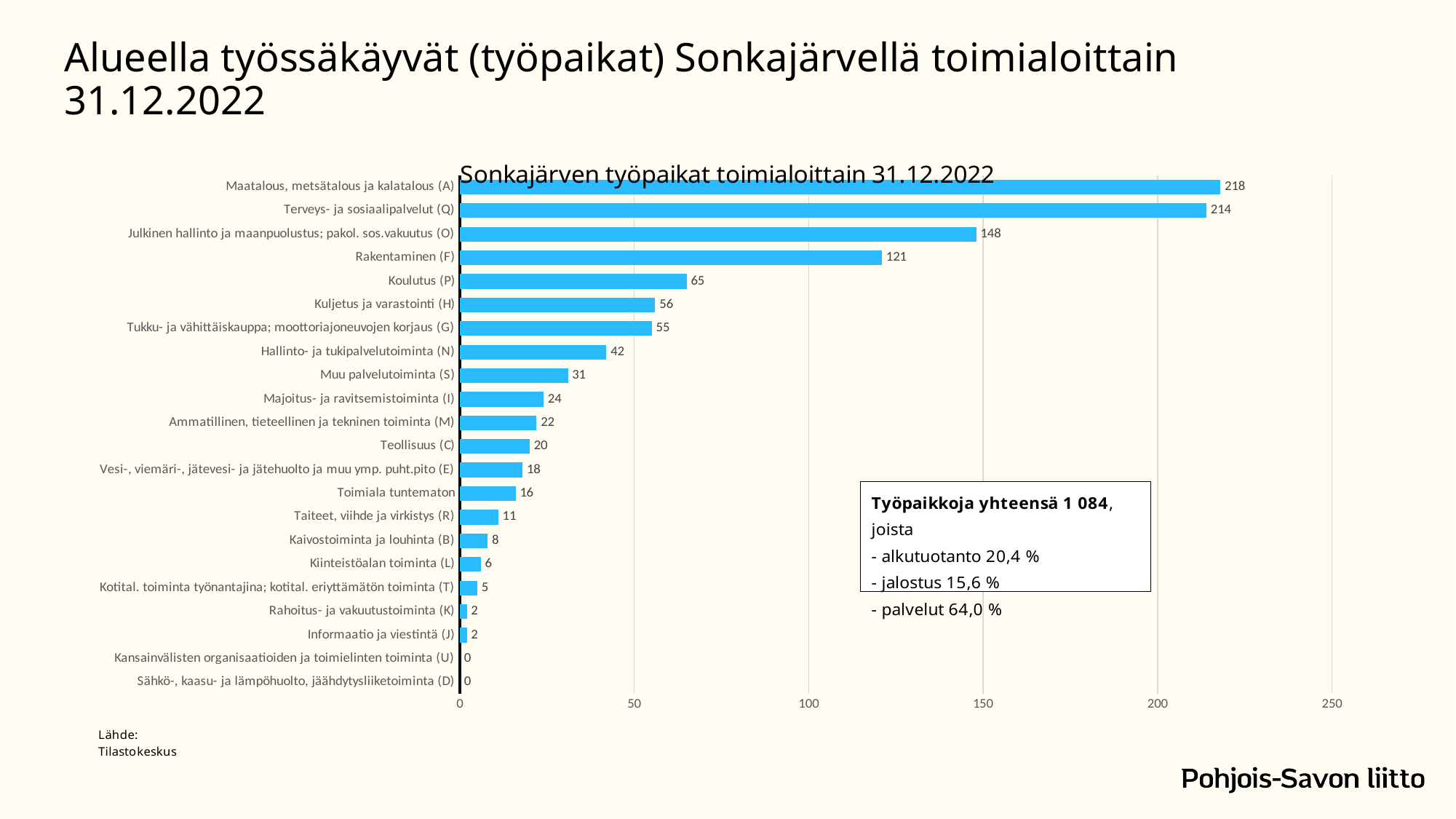
What is the difference between Terveys- ja sosiaalipalvelut (Q) and Julkinen hallinto ja maanpuolustus; pakol. sos.vakuutus (O)? 66 What is the title of the chart? Sonkajärven työpaikat toimialoittain 31.12.2022 What is the value for Koulutus (P)? 65 Is the value for Julkinen hallinto ja maanpuolustus; pakol. sos.vakuutus (O) greater or less than 100? greater What is the value for Maatalous, metsätalous ja kalatalous (A)? 218 What is the value for Kaivostoiminta ja louhinta (B)? 8 What is the value for Taiteet, viihde ja virkistys (R)? 11 What is the value for Rakentaminen (F)? 121 Which is larger, Kuljetus ja varastointi (H) or Hallinto- ja tukipalvelutoiminta (N)? Kuljetus ja varastointi (H) Which category has the highest value? Maatalous, metsätalous ja kalatalous (A) How many categories are shown in the chart? 22 What kind of chart is shown on the slide? bar chart